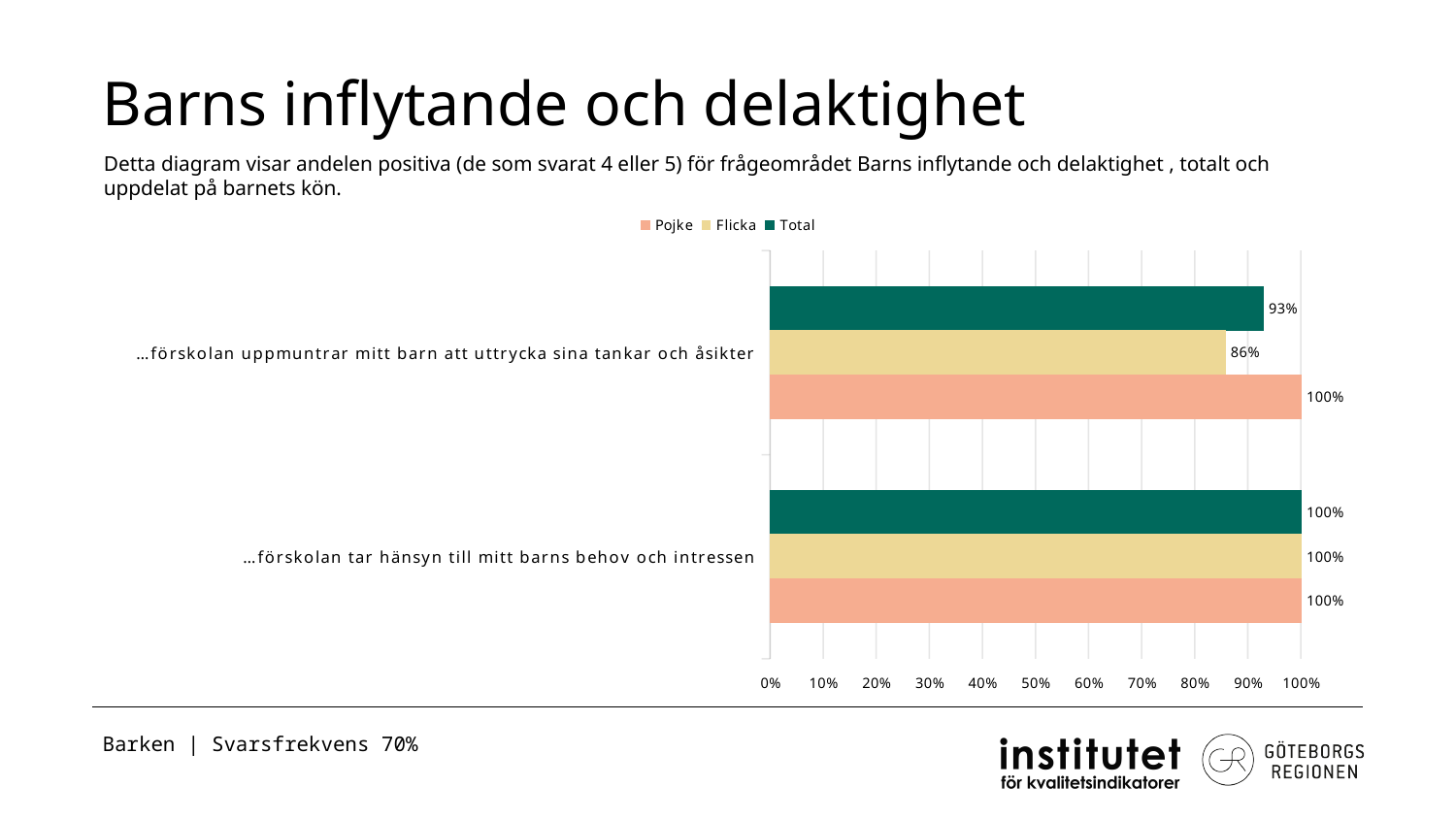
What type of chart is shown on the slide? bar chart What are the three legend entries of the chart? Pojke, Flicka, Total What is the difference between the Pojke and Flicka values for "…förskolan uppmuntrar mitt barn att uttrycka sina tankar och åsikter"? 14% What is the Total value for "…förskolan uppmuntrar mitt barn att uttrycka sina tankar och åsikter"? 93% How many categories are shown on the chart? 2 What is the Pojke value for "…förskolan uppmuntrar mitt barn att uttrycka sina tankar och åsikter"? 100% How many series does the legend list? 3 Which series has the lowest value for "…förskolan uppmuntrar mitt barn att uttrycka sina tankar och åsikter"? Flicka What is the Total value for "…förskolan tar hänsyn till mitt barns behov och intressen"? 100% Which is larger for "…förskolan uppmuntrar mitt barn att uttrycka sina tankar och åsikter": the Total value or the Flicka value? Total What is the Flicka value for "…förskolan uppmuntrar mitt barn att uttrycka sina tankar och åsikter"? 86% Is the Flicka value for "…förskolan uppmuntrar mitt barn att uttrycka sina tankar och åsikter" greater or less than 90%? less